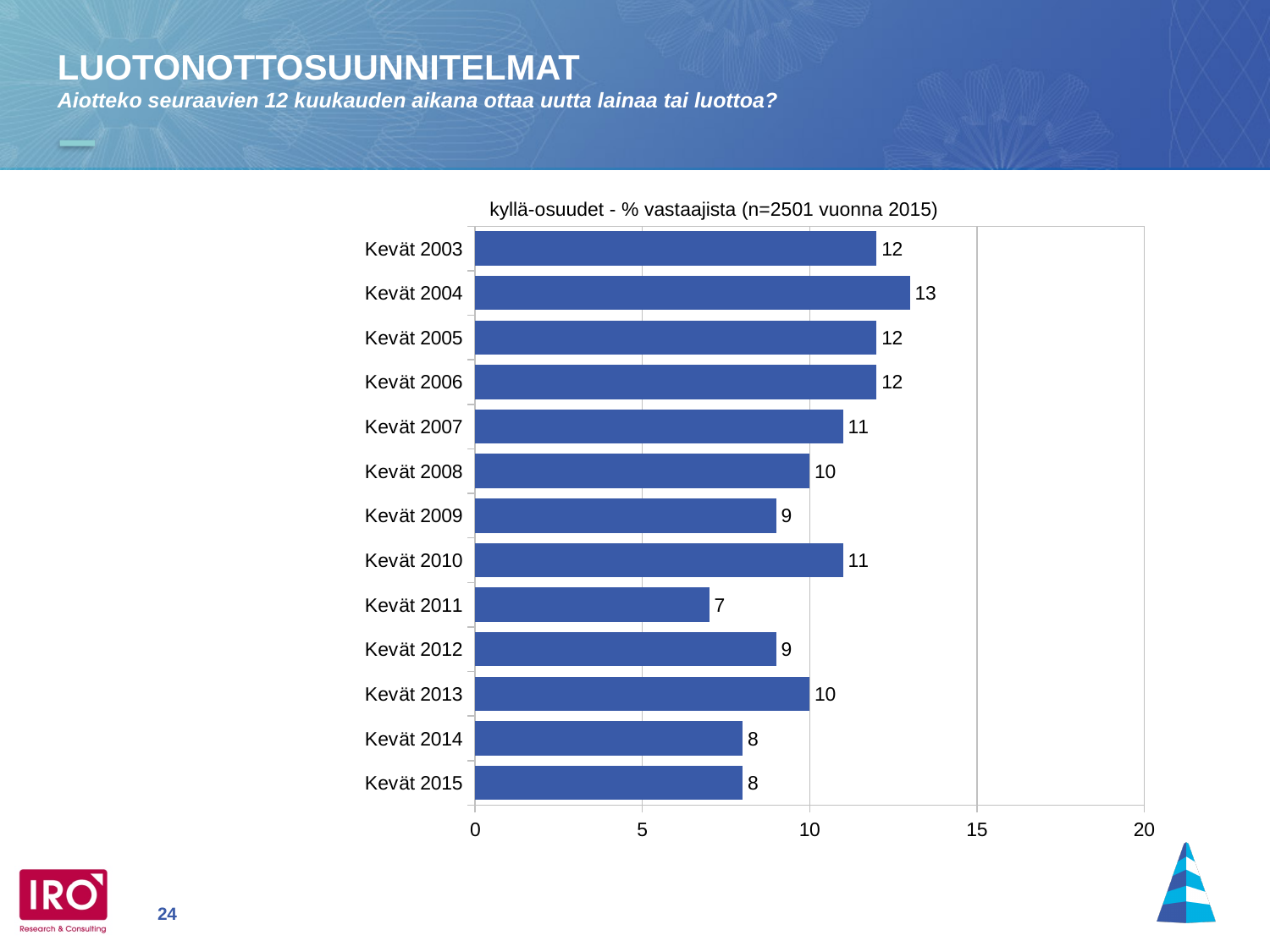
What is the difference between the values for Kevät 2004 and Kevät 2011? 6 What is the difference between the values for Kevät 2003 and Kevät 2015? 4 Which is larger, the value for Kevät 2010 or the value for Kevät 2012? Kevät 2010 Which category has the highest value? Kevät 2004 Is the value for Kevät 2007 greater or less than 10? greater What is the value for Kevät 2015? 8 Which category has the lowest value? Kevät 2011 What kind of chart is shown on the slide? bar chart What is the value for Kevät 2011? 7 What is the value for Kevät 2004? 13 How many categories are shown in the chart? 13 What is the title of the chart? kyllä-osuudet - % vastaajista (n=2501 vuonna 2015)